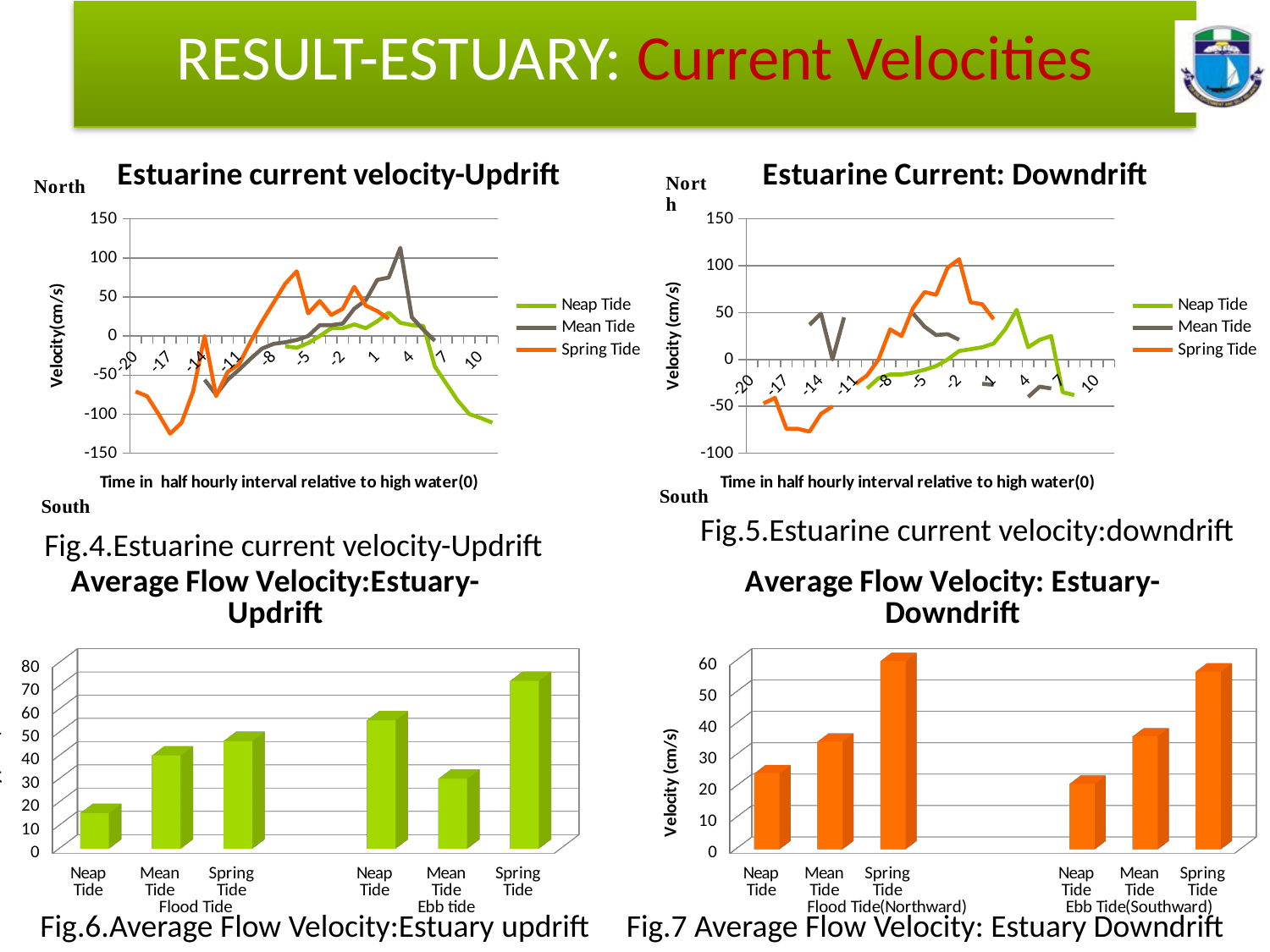
In the "Estuarine current velocity-Updrift" chart, which series is shown in orange? Spring Tide What is the x-axis label of the "Estuarine Current: Downdrift" chart? Time in half hourly interval relative to high water(0) What kind of chart is the "Estuarine current velocity-Updrift" chart? line chart In the "Average Flow Velocity: Estuary-Downdrift" chart, is the Ebb Tide(Southward) Spring Tide value greater or less than 50? greater What kind of chart is the "Average Flow Velocity:Estuary-Updrift" chart? bar chart In the "Average Flow Velocity:Estuary-Updrift" chart, which bar is the lowest? Neap Tide (Flood Tide) In the "Average Flow Velocity:Estuary-Updrift" chart, which is larger: the Ebb tide Neap Tide bar or the Ebb tide Mean Tide bar? Ebb tide Neap Tide In the "Average Flow Velocity:Estuary-Updrift" chart, is the Flood Tide Neap Tide value greater or less than 20? less How many bars are plotted in the "Average Flow Velocity: Estuary-Downdrift" chart? 6 How many series does the legend of the "Estuarine Current: Downdrift" chart list? 3 In the "Average Flow Velocity:Estuary-Updrift" chart, which bar is the highest? Spring Tide (Ebb tide) In the "Average Flow Velocity: Estuary-Downdrift" chart, which bar is the highest? Spring Tide (Flood Tide(Northward))